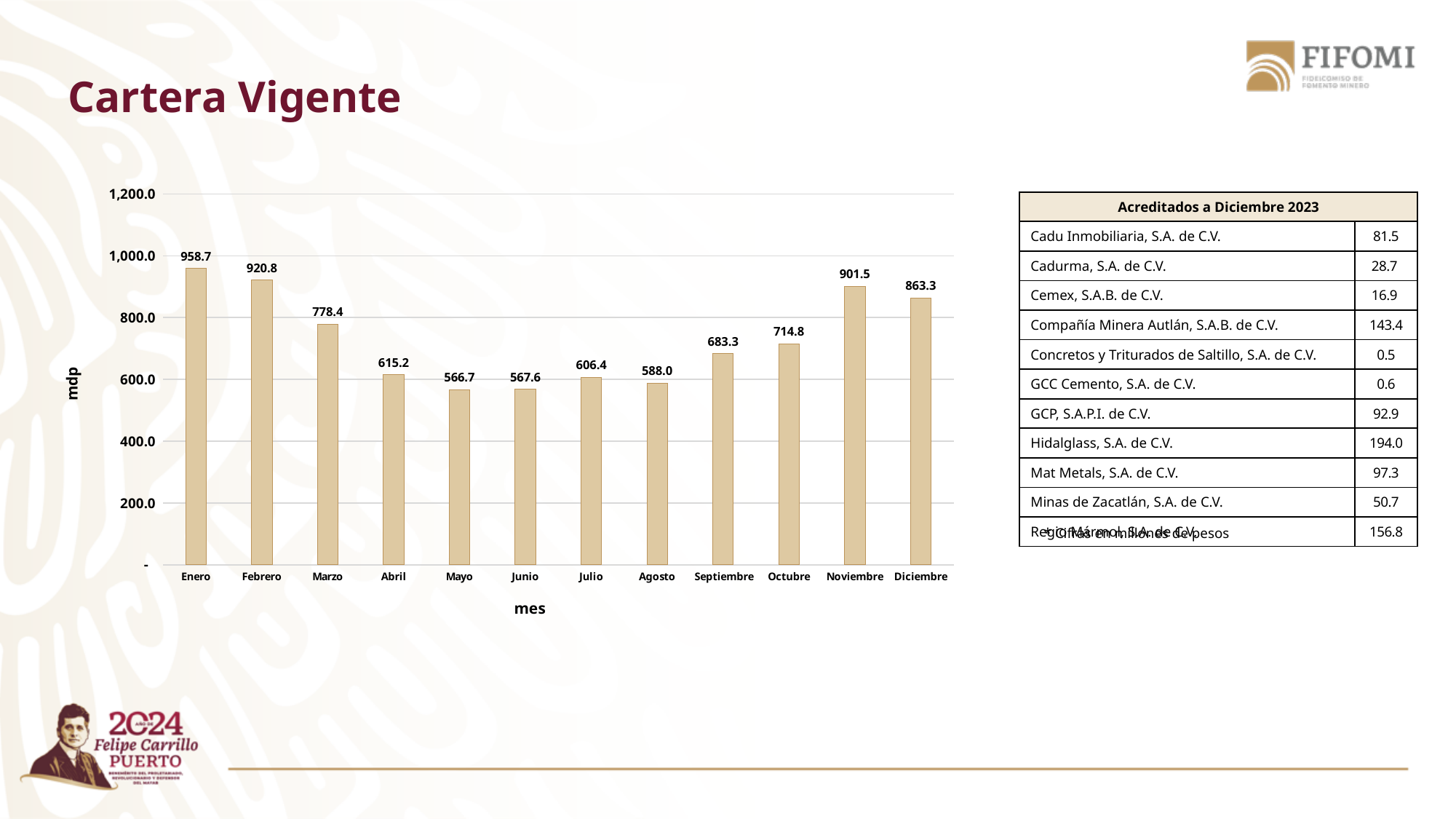
What kind of chart is shown on the slide? bar chart What is the difference between the values for Noviembre and Diciembre? 38.2 What is the difference between the values for Enero and Febrero? 37.9 Which month has the highest value? Enero Which month has the lowest value? Mayo What is the label of the y axis? mdp What is the value for Diciembre? 863.3 Is the value for Abril greater or less than 800.0? less How many months are shown on the x axis? 12 What is the value for Octubre? 714.8 What is the value for Enero? 958.7 Which is larger, the value for Marzo or the value for Septiembre? Marzo